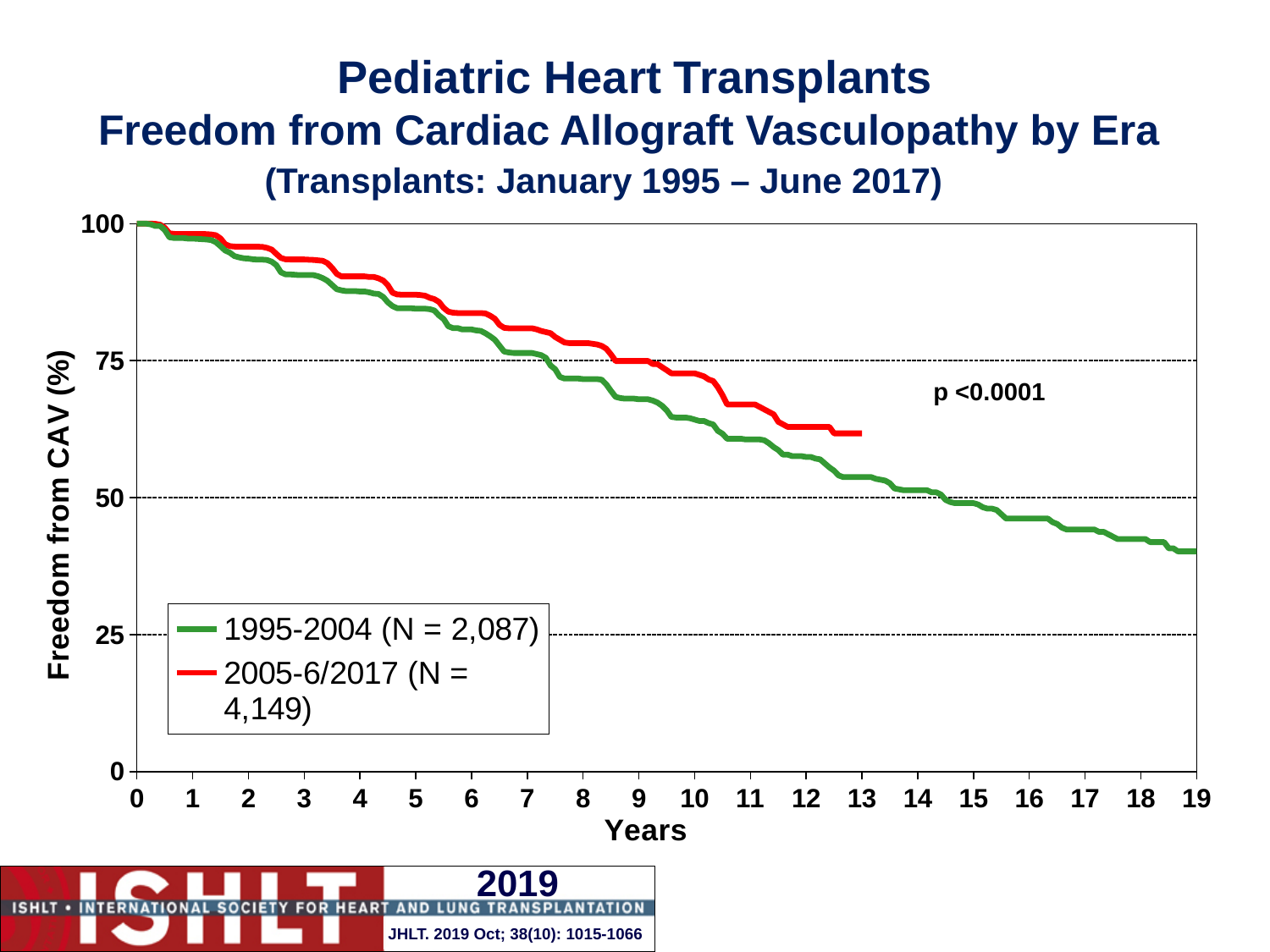
Is the freedom from CAV for the 2005-6/2017 era at 13 years greater or less than 50? greater At 10 years, which era has the higher freedom from CAV? 2005-6/2017 Is the freedom from CAV for the 2005-6/2017 era at 5 years greater or less than 75? greater According to the legend, what is the N for the 1995-2004 era? 2,087 Do the freedom from CAV values rise or fall as years increase? fall What p-value is printed on the chart? p <0.0001 How many series does the legend list? 2 Is the freedom from CAV for the 1995-2004 era at 10 years greater or less than 75? less What kind of chart is shown on the slide? line chart